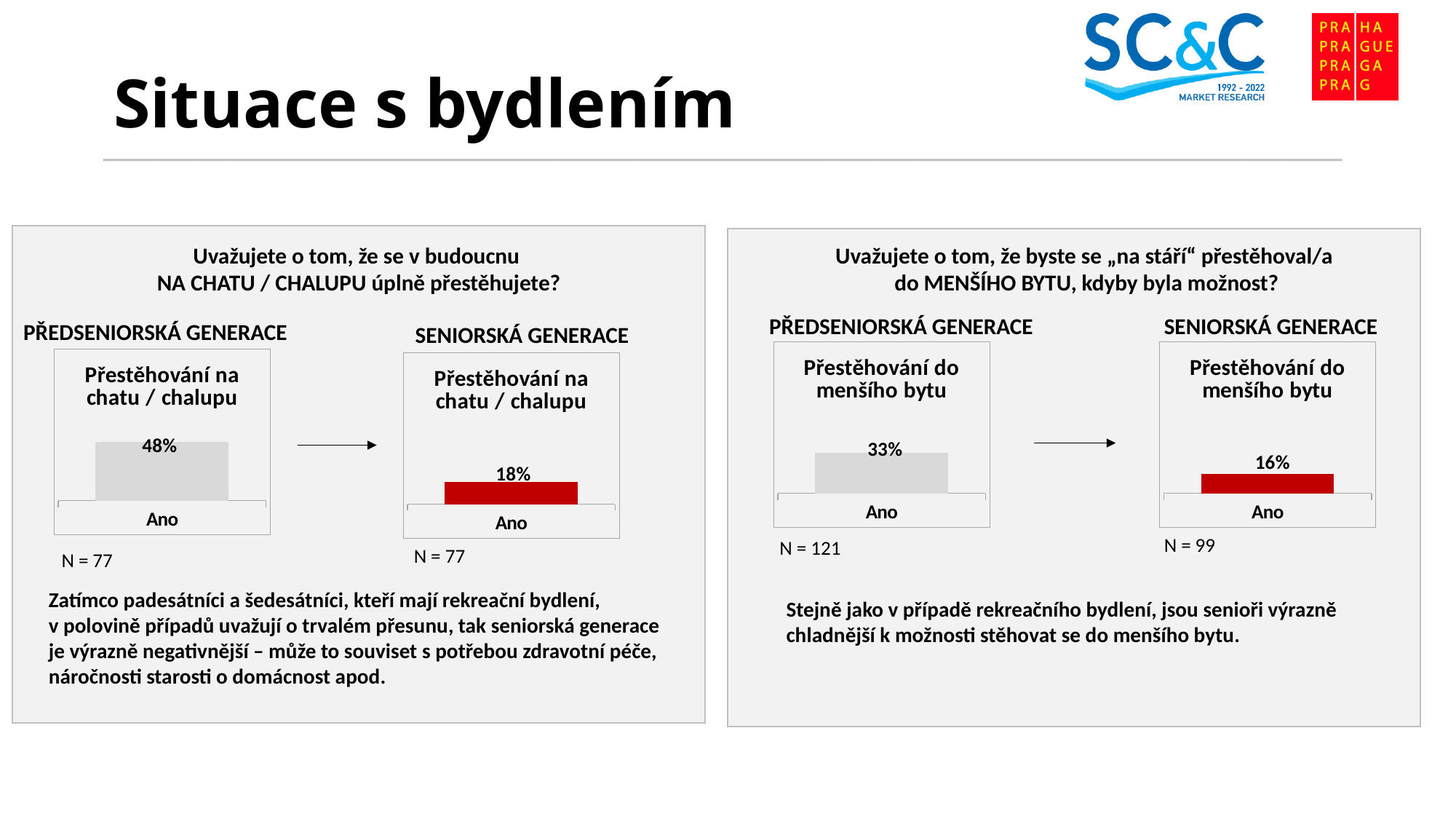
In the 'Přestěhování na chatu / chalupu' chart for the PŘEDSENIORSKÁ GENERACE, what is the value for 'Ano'? 48% Which generation has the higher 'Ano' value in the 'Přestěhování do menšího bytu' charts? PŘEDSENIORSKÁ GENERACE Which is larger: the 'Ano' value in the 'Přestěhování na chatu / chalupu' chart for the SENIORSKÁ GENERACE or in the 'Přestěhování do menšího bytu' chart for the SENIORSKÁ GENERACE? Přestěhování na chatu / chalupu In the 'Přestěhování do menšího bytu' chart for the SENIORSKÁ GENERACE, what is the value for 'Ano'? 16% Comparing the two 'Přestěhování do menšího bytu' charts, what is the difference between the PŘEDSENIORSKÁ GENERACE value and the SENIORSKÁ GENERACE value? 17% What colour is the bar in the 'Přestěhování na chatu / chalupu' chart for the SENIORSKÁ GENERACE? red In the 'Přestěhování do menšího bytu' chart for the PŘEDSENIORSKÁ GENERACE, what is the value for 'Ano'? 33% What kind of chart is the 'Přestěhování na chatu / chalupu' chart for the PŘEDSENIORSKÁ GENERACE? bar chart What is the category label under the bar in the 'Přestěhování do menšího bytu' chart for the PŘEDSENIORSKÁ GENERACE? Ano Comparing the two 'Přestěhování na chatu / chalupu' charts, what is the difference between the PŘEDSENIORSKÁ GENERACE value and the SENIORSKÁ GENERACE value? 30% In the 'Přestěhování na chatu / chalupu' chart for the SENIORSKÁ GENERACE, what is the value for 'Ano'? 18% How many bars are plotted in the 'Přestěhování do menšího bytu' chart for the SENIORSKÁ GENERACE? 1